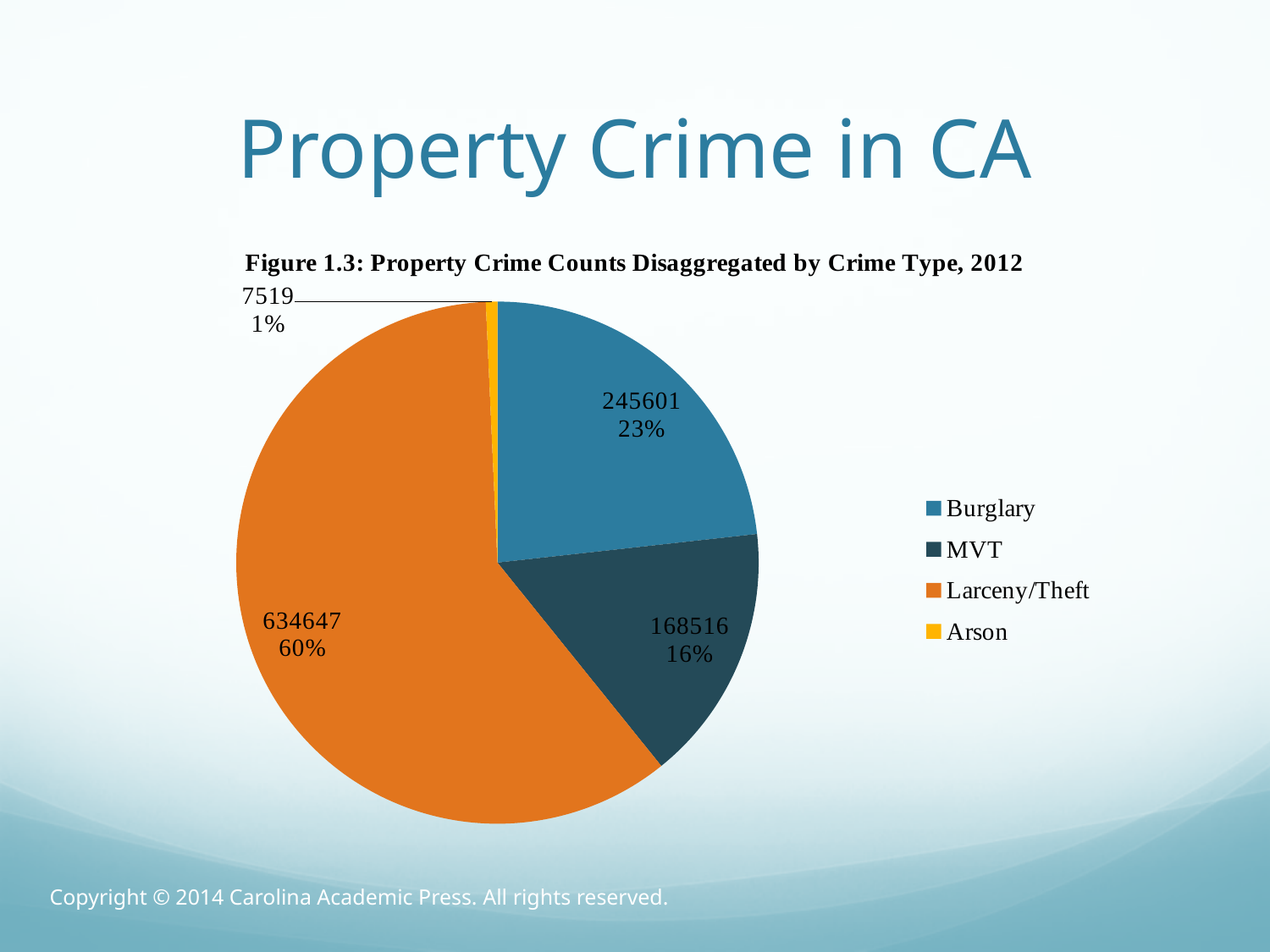
Which is larger, the count for Burglary or the count for MVT? Burglary What is the count for Arson? 7519 Which crime type has the largest slice of the pie? Larceny/Theft How many crime types are shown in the pie chart? 4 What is the count for Larceny/Theft? 634647 What kind of chart is shown on the slide? Pie chart What share of the pie does Burglary represent? 23% What is the difference between the Burglary count and the MVT count? 77085 Which crime type has the smallest slice of the pie? Arson What share of the pie does MVT represent? 16% What is the count for MVT? 168516 What is the count for Burglary? 245601